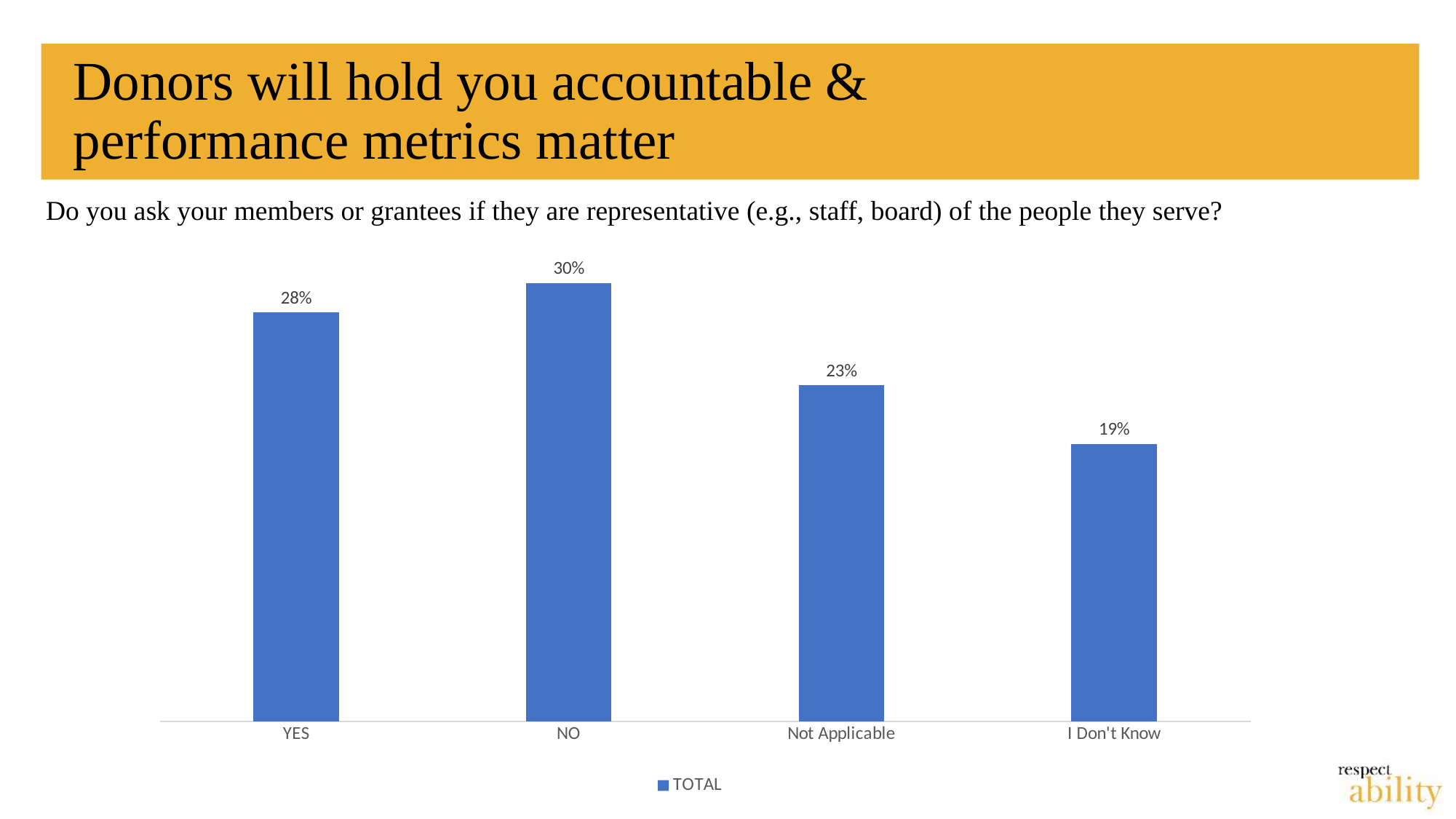
What is the difference between the values for Not Applicable and I Don't Know? 4% What is the value for I Don't Know? 19% What is the value for NO? 30% How many categories are shown on the x axis? 4 What kind of chart is shown on the slide? Bar chart What is the difference between the values for NO and YES? 2% Which category has the highest value? NO Which category has the lowest value? I Don't Know Which is larger, the value for YES or the value for Not Applicable? YES What is the value for Not Applicable? 23% How many series does the legend list? 1 What is the value for YES? 28%